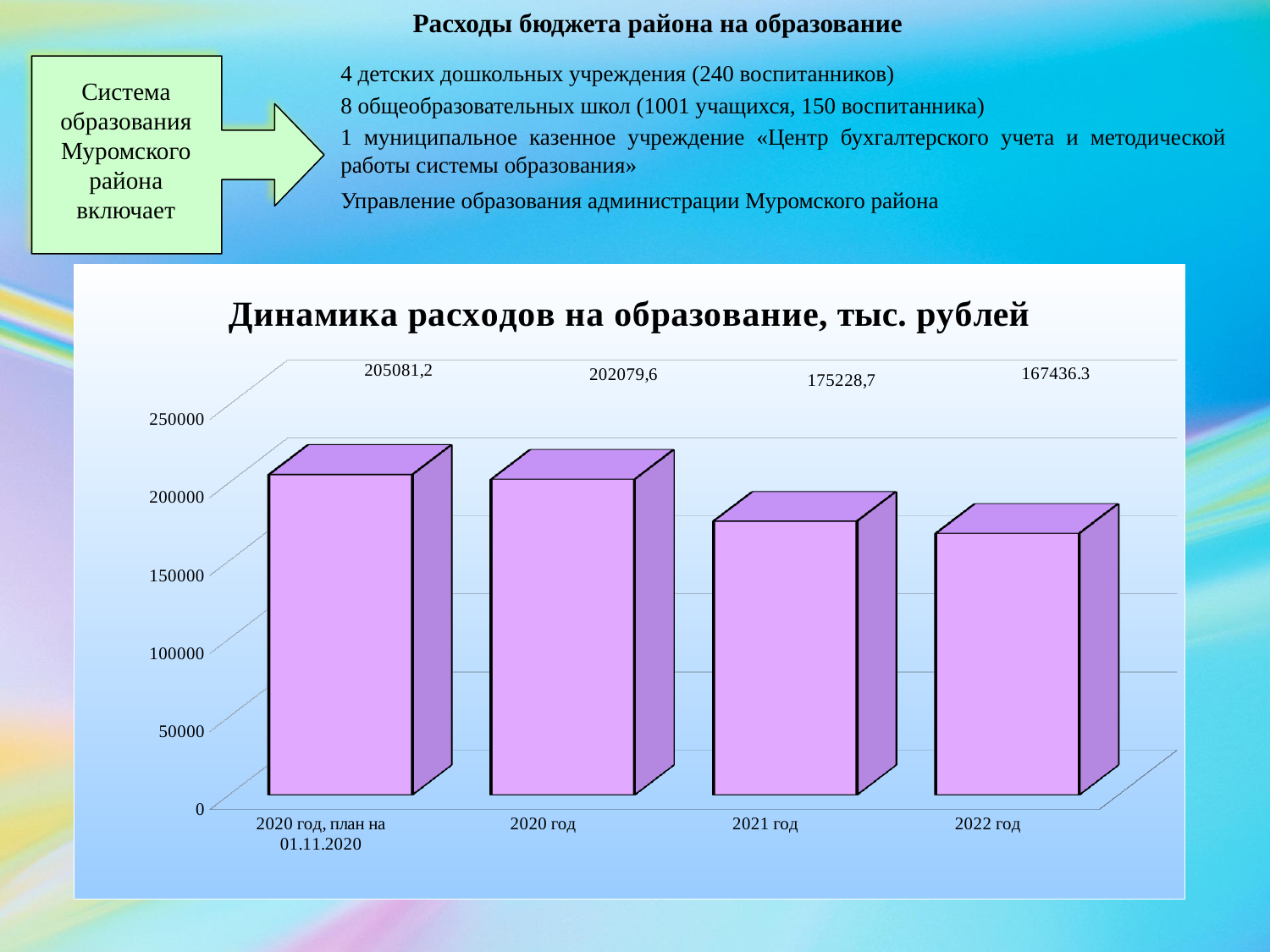
What is the value for '2020 год, план на 01.11.2020'? 205081,2 What is the difference between the values for '2020 год, план на 01.11.2020' and 2020 год? 3001,6 What is the difference between the values for 2021 год and 2022 год? 7792,4 How many bars are shown in the chart? 4 What is the value for 2022 год in the chart? 167436.3 Which category has the highest value in the chart? 2020 год, план на 01.11.2020 Do the values rise or fall from left to right along the x axis? fall What is the value for 2021 год in the chart 'Динамика расходов на образование, тыс. рублей'? 175228,7 What kind of chart is shown on the slide? bar chart Which is larger: the value for 2020 год or the value for 2021 год? 2020 год What is the value for 2020 год? 202079,6 Which category has the lowest value in the chart? 2022 год